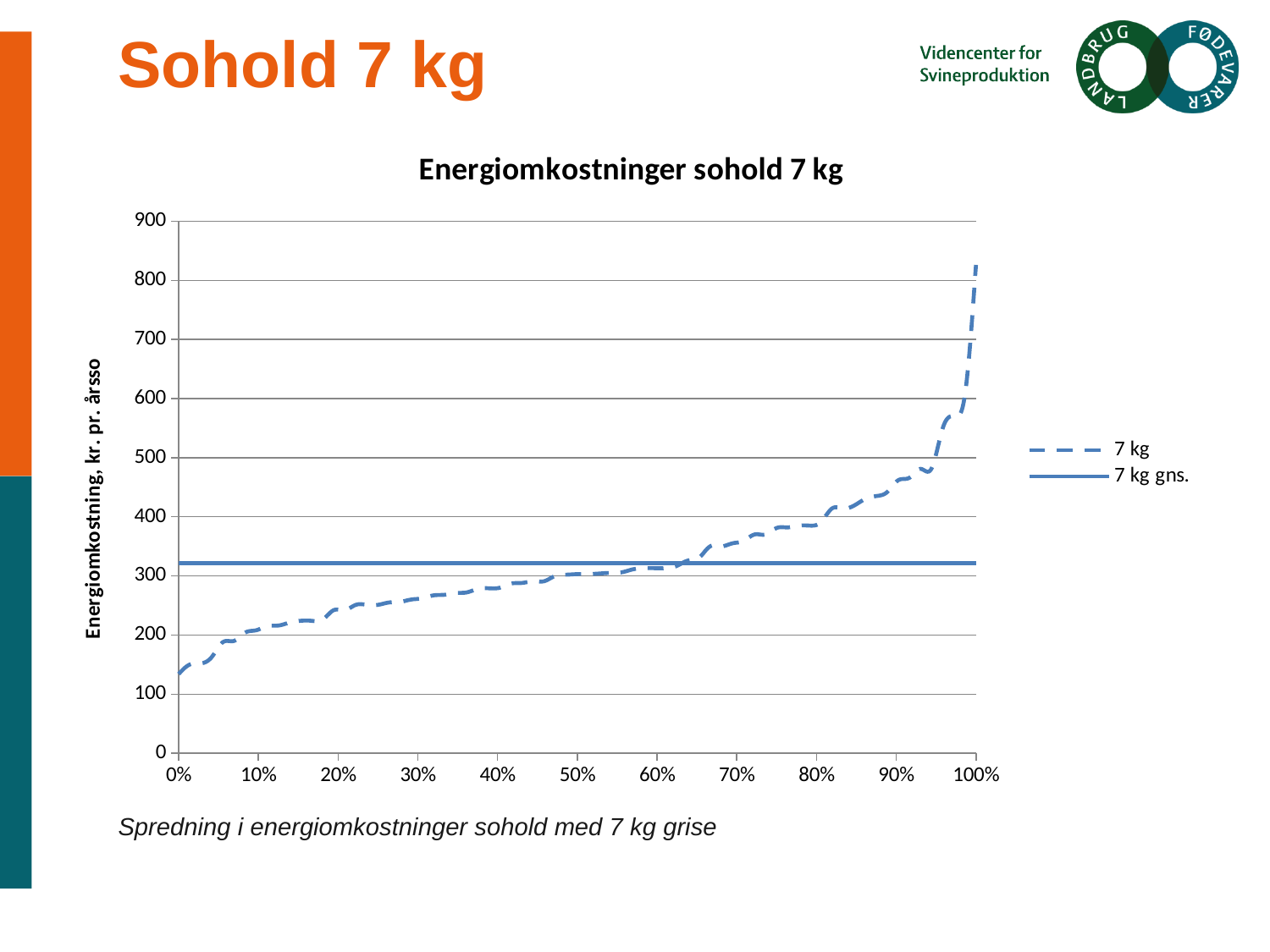
Is the value of the '7 kg' series at 90% greater or less than 400? greater Is the value of the '7 kg' series at 20% greater or less than 300? less What kind of chart is shown on the slide? line chart What is the label of the vertical axis? Energiomkostning, kr. pr. årsso At 100%, which series has the larger value, '7 kg' or '7 kg gns.'? 7 kg Does the dashed '7 kg' line rise or fall as the x axis goes from 0% to 100%? rise Is the value of the '7 kg gns.' line greater or less than 400? less What is the title of the chart? Energiomkostninger sohold 7 kg How many series does the legend list? 2 At 0%, which series has the larger value, '7 kg' or '7 kg gns.'? 7 kg gns.